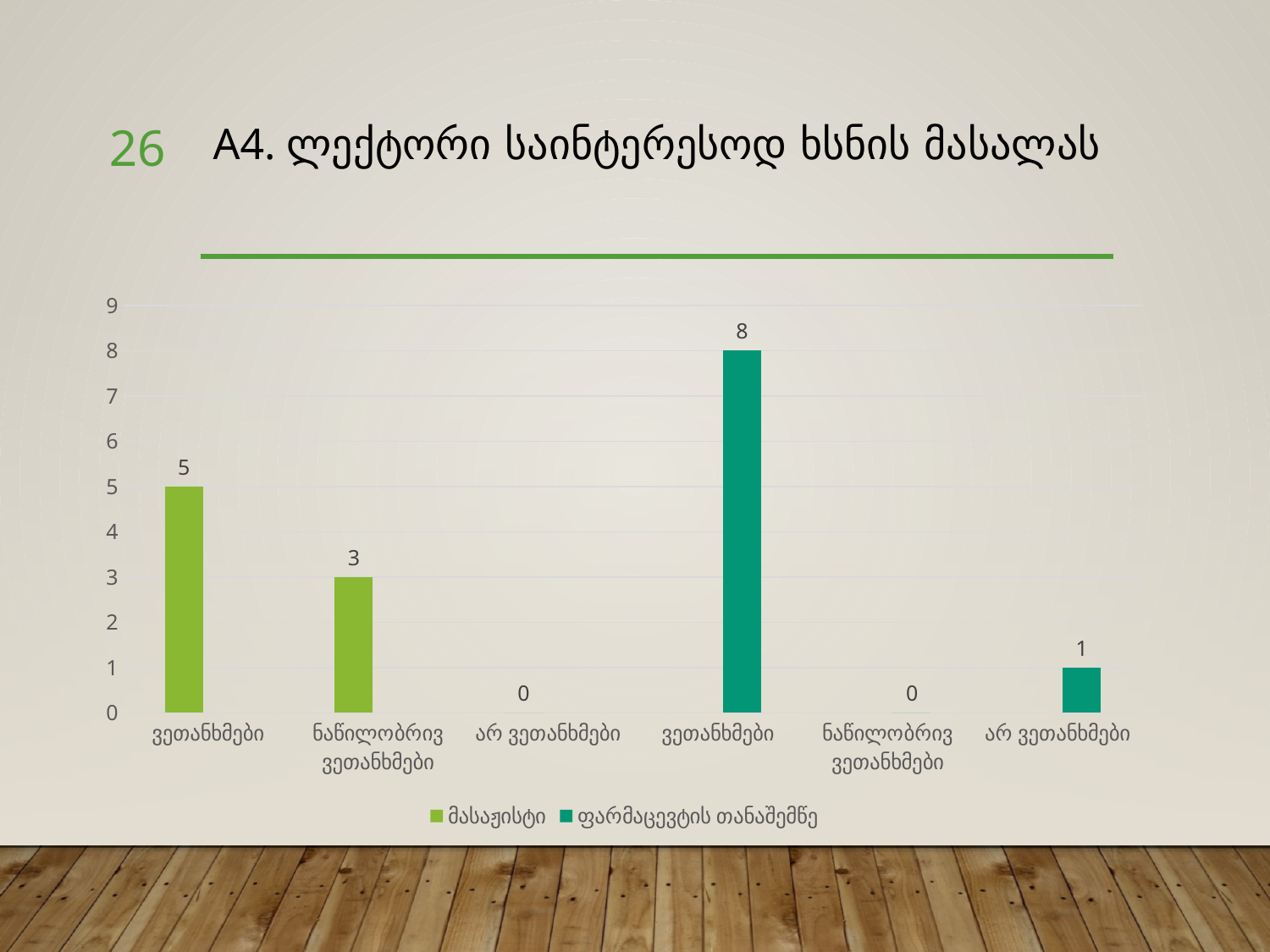
What is the difference between the ვეთანხმები values for ფარმაცევტის თანაშემწე and მასაჟისტი? 3 How many category labels are shown along the x axis? 6 What is the highest value shown on the vertical axis? 9 What is the value of the ფარმაცევტის თანაშემწე bar for არ ვეთანხმები? 1 What is the value of the მასაჟისტი bar for ნაწილობრივ ვეთანხმები? 3 What is the value of the ფარმაცევტის თანაშემწე bar for ვეთანხმები? 8 How many series does the legend list? 2 What is the value of the მასაჟისტი bar for ვეთანხმები? 5 Which bar has the highest value in the chart? ვეთანხმები (ფარმაცევტის თანაშემწე) What is the title of the chart slide? A4. ლექტორი საინტერესოდ ხსნის მასალას Which is larger: the მასაჟისტი value for ნაწილობრივ ვეთანხმები or the ფარმაცევტის თანაშემწე value for არ ვეთანხმები? მასაჟისტი value for ნაწილობრივ ვეთანხმები What type of chart is shown on the slide? bar chart